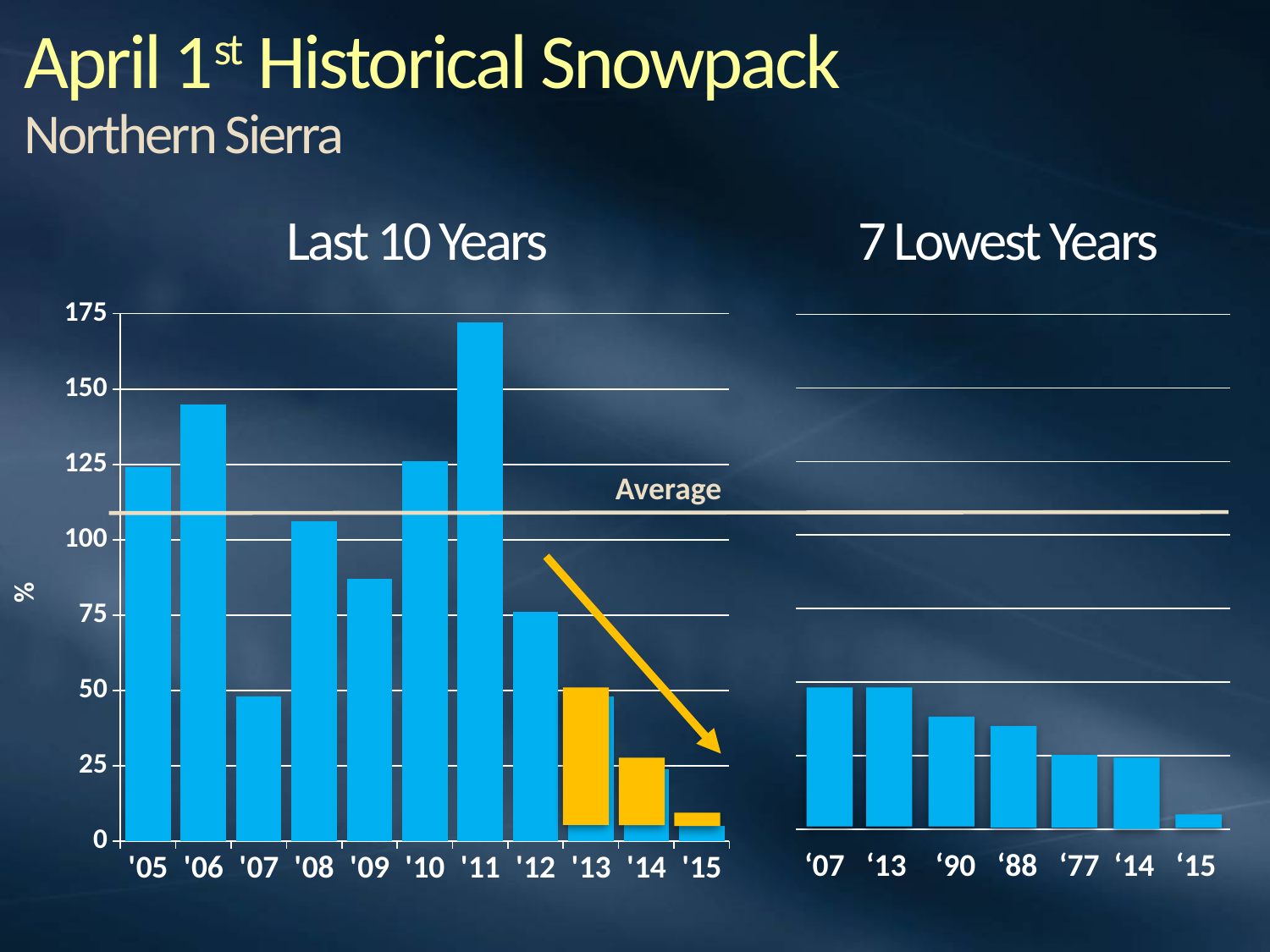
In the "Last 10 Years" chart, is the value for '09 greater or less than 100? less In the "Last 10 Years" chart, is the value for '11 greater or less than 150? greater How many years are shown in the "7 Lowest Years" chart? 7 In the "Last 10 Years" chart, which year has the highest bar? '11 What kind of chart is the "Last 10 Years" chart? bar chart In the "Last 10 Years" chart, which is larger, the value for '06 or the value for '10? '06 In the "Last 10 Years" chart, which year has the lowest bar? '15 In the "7 Lowest Years" chart, do the bars rise or fall from left to right? fall In the "Last 10 Years" chart, is the value for '15 greater or less than 25? less What label is given to the horizontal line drawn across both charts? Average In the "7 Lowest Years" chart, which year has the lowest bar? '15 How many years are shown on the x axis of the "Last 10 Years" chart? 11